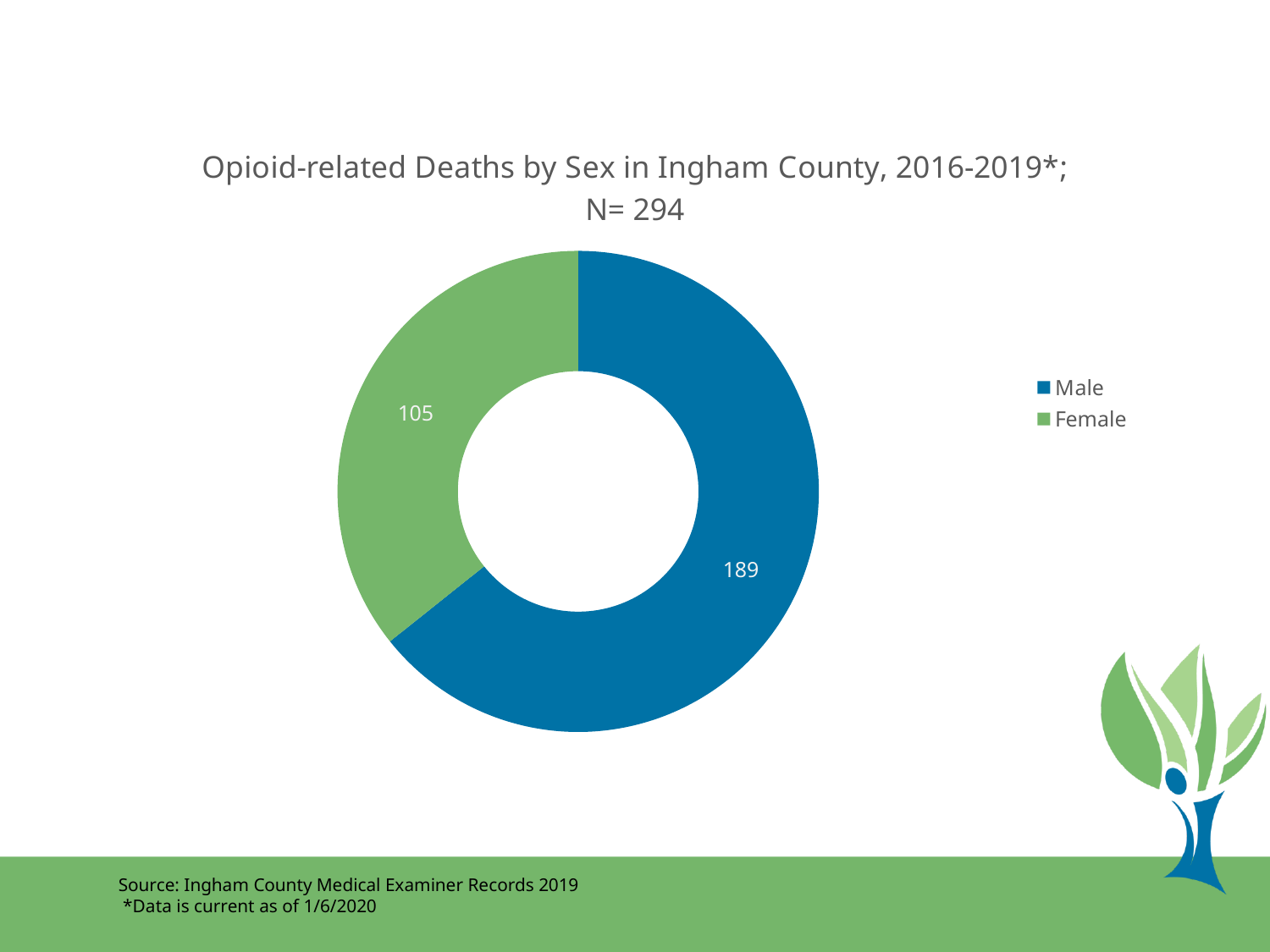
Which sex accounts for the smaller share of opioid-related deaths? Female What is the title of the chart? Opioid-related Deaths by Sex in Ingham County, 2016-2019*; N= 294 Are there more male or female opioid-related deaths? Male How many opioid-related deaths were among males? 189 How many opioid-related deaths were among females? 105 What kind of chart is shown on the slide? Doughnut (pie) chart What is the total number of opioid-related deaths shown (N)? 294 What colour represents Female in the chart? Green Which sex accounts for the larger share of opioid-related deaths? Male How many categories does the chart show? 2 What is the difference between male and female opioid-related deaths? 84